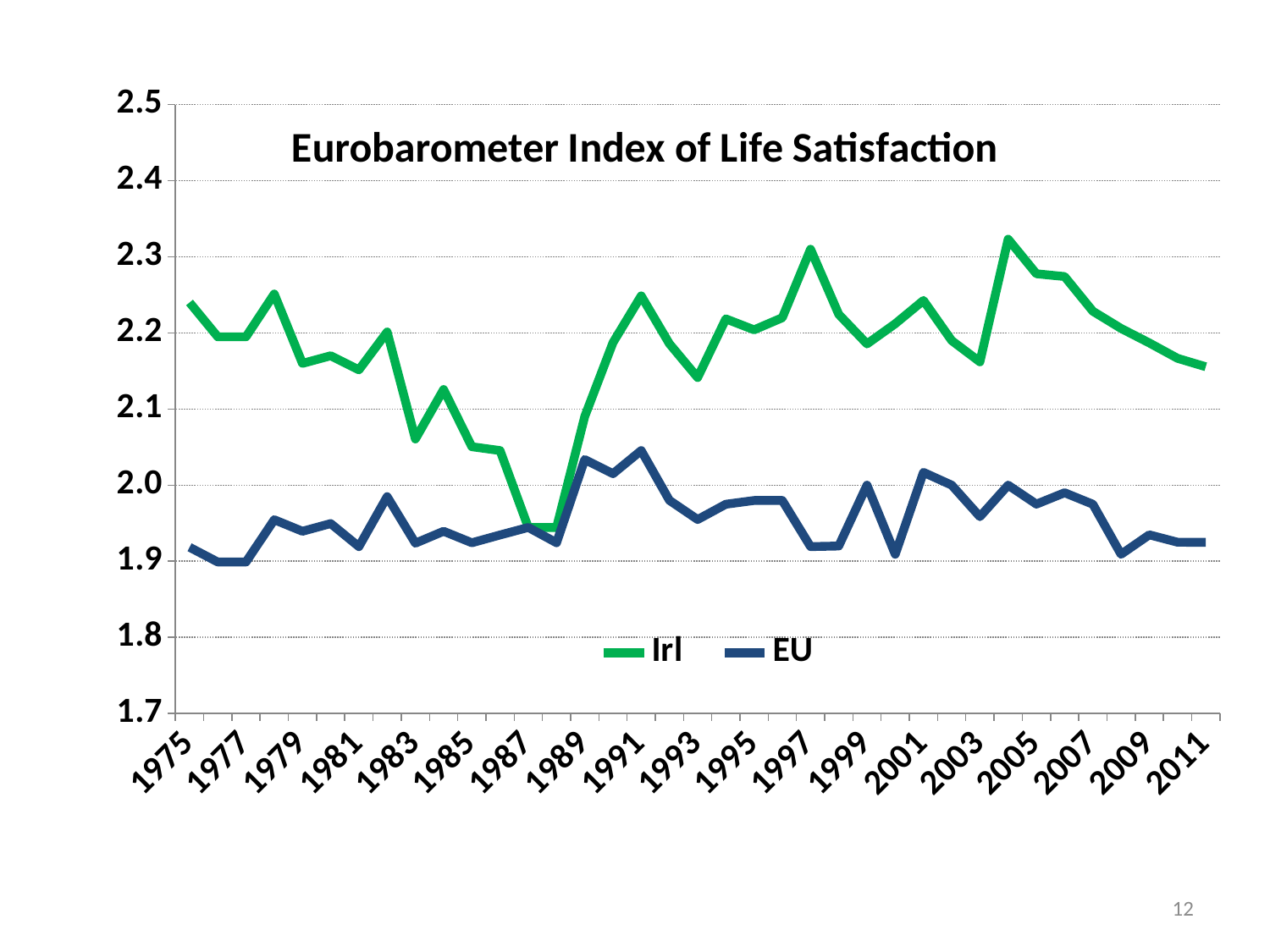
In which year does the Irl series reach its highest value? 2004 How many year labels are shown on the x axis? 19 What is the title of the chart? Eurobarometer Index of Life Satisfaction Is the Irl value in 2011 greater or less than 2.1? greater What type of chart is shown on the slide? line chart Does the Irl series rise or fall between 2005 and 2011? fall Which colour is used for the Irl series? green Is the EU value in 1975 greater or less than 2.0? less How many series does the legend list? 2 Which series has the higher value in 1975, Irl or EU? Irl Is the EU value in 2011 greater or less than 2.0? less